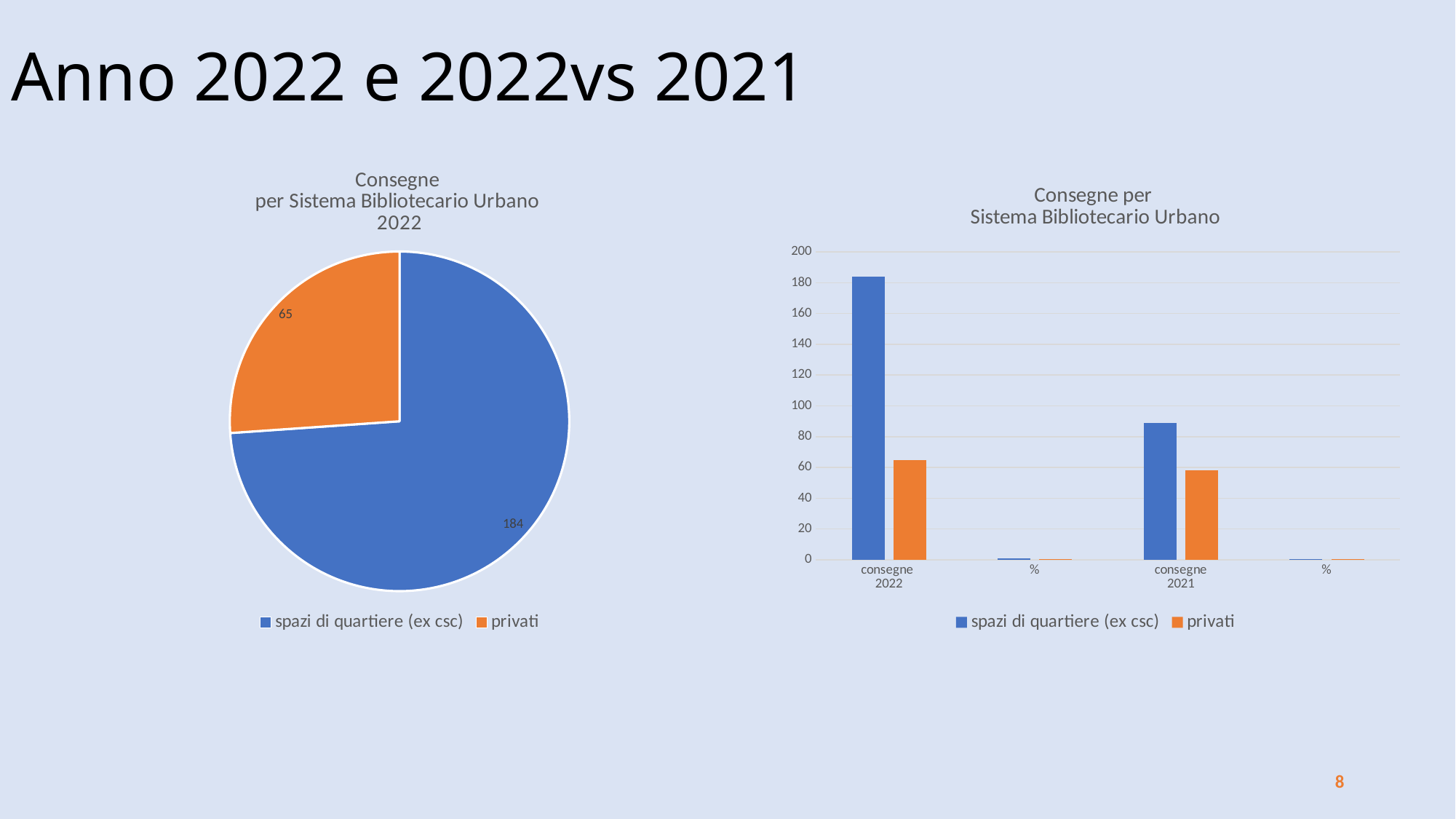
On the bar chart on the right, how many series does the legend list? 2 On the bar chart on the right, which series has the taller bar in 'consegne 2021', 'spazi di quartiere (ex csc)' or 'privati'? spazi di quartiere (ex csc) On the pie chart on the left, which category has the largest slice? spazi di quartiere (ex csc) On the bar chart on the right, is the value for 'spazi di quartiere (ex csc)' in 'consegne 2021' greater or less than 100? less On the pie chart on the left, what share of the total does 'privati' represent? 26.1% On the bar chart on the right, is the value for 'spazi di quartiere (ex csc)' in 'consegne 2022' greater or less than 160? greater On the pie chart on the left, what is the total of the two slices? 249 What kind of chart is the chart on the right of the slide? bar chart On the pie chart on the left, what is the difference between the value for 'spazi di quartiere (ex csc)' and the value for 'privati'? 119 What kind of chart is the chart on the left of the slide? pie chart On the pie chart titled 'Consegne per Sistema Bibliotecario Urbano 2022', what is the value for 'privati'? 65 On the pie chart titled 'Consegne per Sistema Bibliotecario Urbano 2022', what is the value for 'spazi di quartiere (ex csc)'? 184